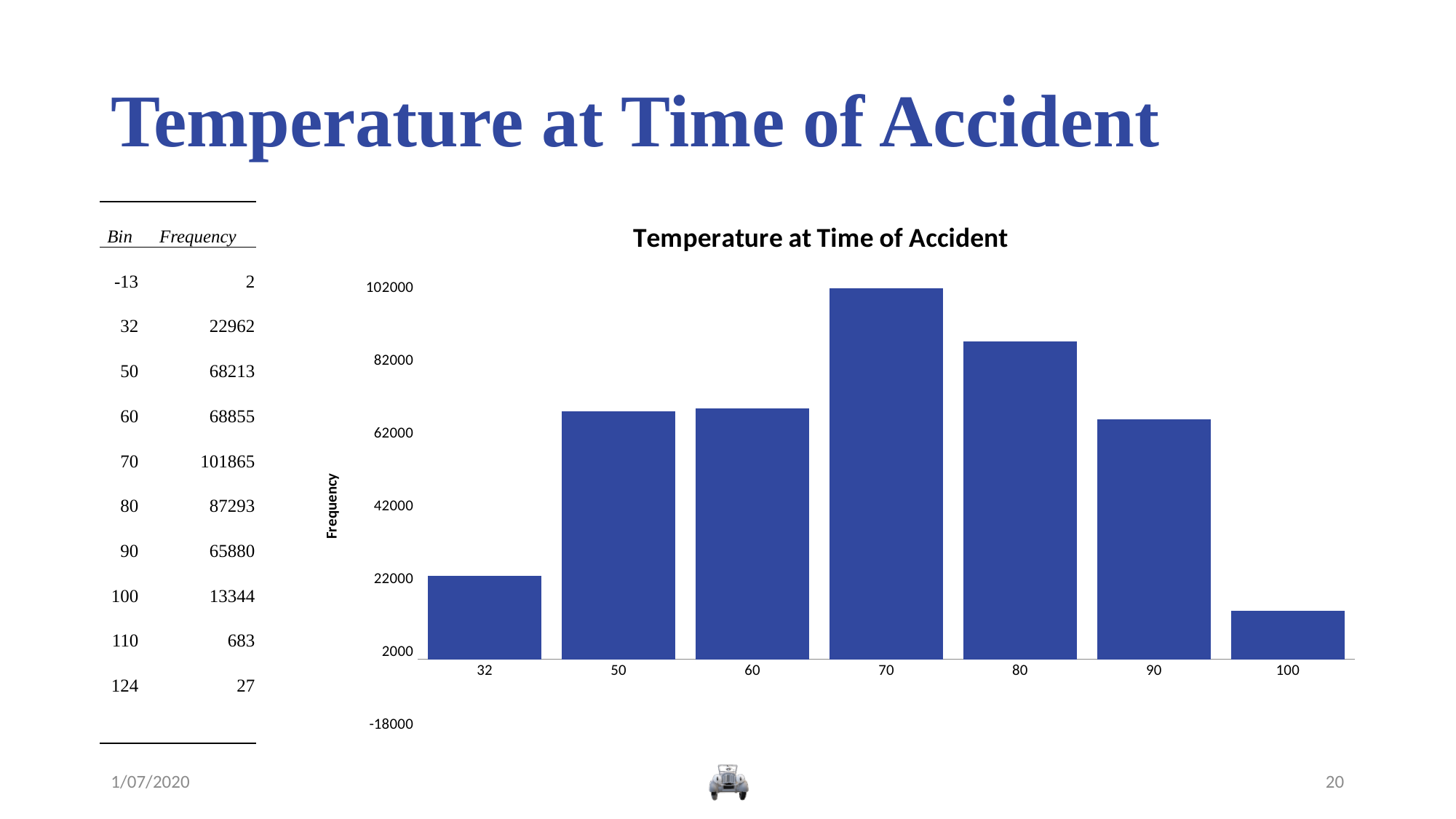
Which temperature bin has the lowest frequency in the chart? 100 Is the value for the 100 bin greater or less than 22000? less What type of chart is shown on the slide? bar chart Which bar is taller in the chart, the one for 80 or the one for 90? 80 According to the table on the slide, what is the frequency for the 32 bin? 22962 According to the table on the slide, what is the frequency for the 70 bin? 101865 What is the label on the vertical axis of the chart? Frequency What is the title of the chart? Temperature at Time of Accident Using the frequencies in the table, what is the difference between the 70 bin and the 80 bin? 14572 Is the value for the 70 bin greater or less than 82000? greater Which temperature bin has the highest frequency in the chart? 70 How many bars are plotted in the chart? 7